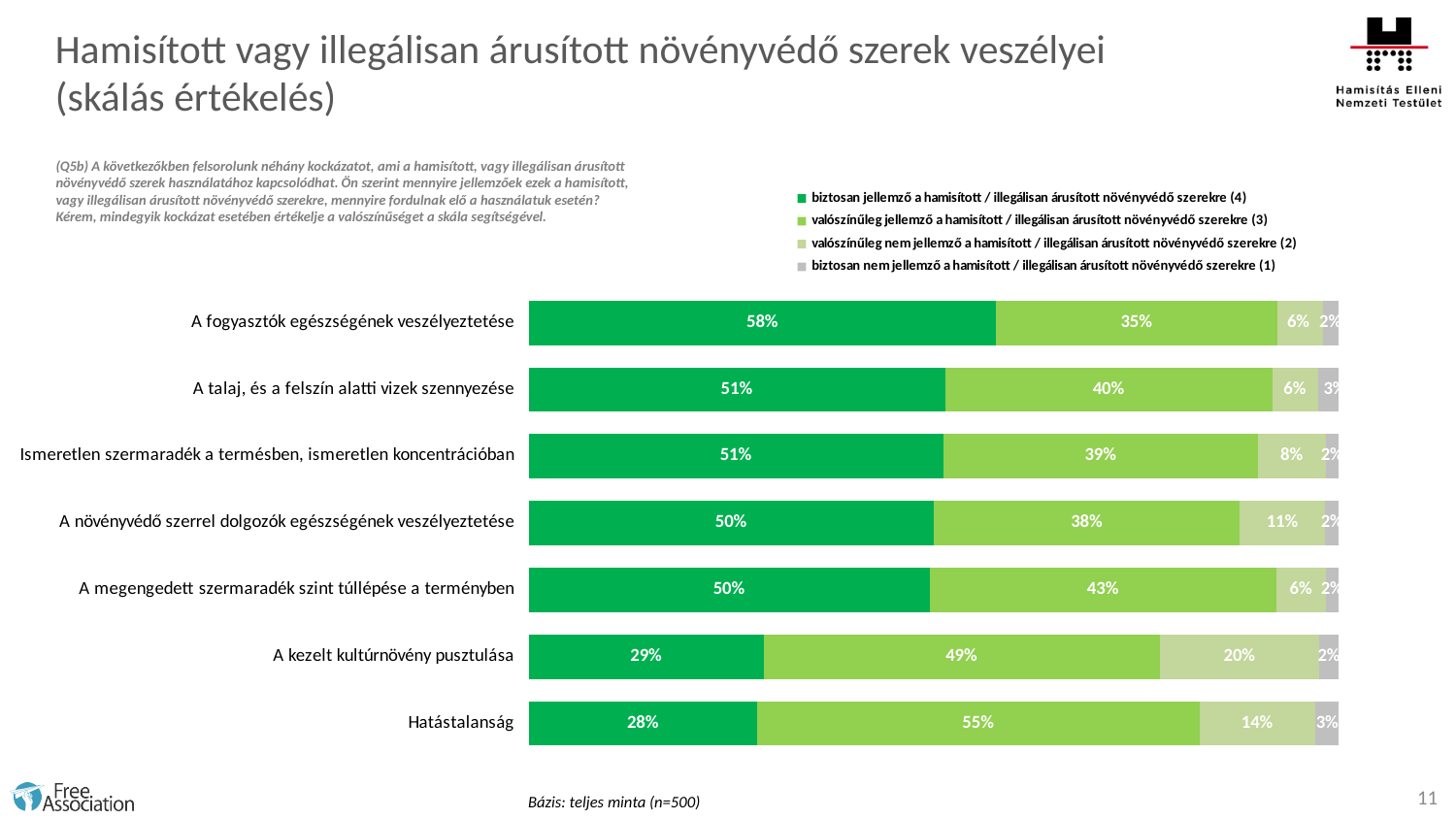
What sample size is given in the base note at the bottom of the slide? n=500 How many categories (risks) are plotted in the chart? 7 What is the value of 'valószínűleg nem jellemző' (2) for 'A kezelt kultúrnövény pusztulása'? 20% How many series does the legend list? 4 Which has a larger 'valószínűleg jellemző' (3) value: 'A megengedett szermaradék szint túllépése a terményben' or 'A talaj, és a felszín alatti vizek szennyezése'? A megengedett szermaradék szint túllépése a terményben What is the difference between the 'biztosan jellemző' (4) values for 'A fogyasztók egészségének veszélyeztetése' and 'A kezelt kultúrnövény pusztulása'? 29 percentage points What kind of chart is shown on the slide? stacked bar chart What is the value of 'valószínűleg jellemző' (3) for 'Hatástalanság'? 55% Which category has the highest 'biztosan jellemző' (4) value? A fogyasztók egészségének veszélyeztetése What is the value of 'biztosan jellemző' (4) for 'A fogyasztók egészségének veszélyeztetése'? 58% What is the combined share of 'biztosan jellemző' (4) and 'valószínűleg jellemző' (3) for 'A növényvédő szerrel dolgozók egészségének veszélyeztetése'? 88% Which category has the lowest 'biztosan jellemző' (4) value? Hatástalanság